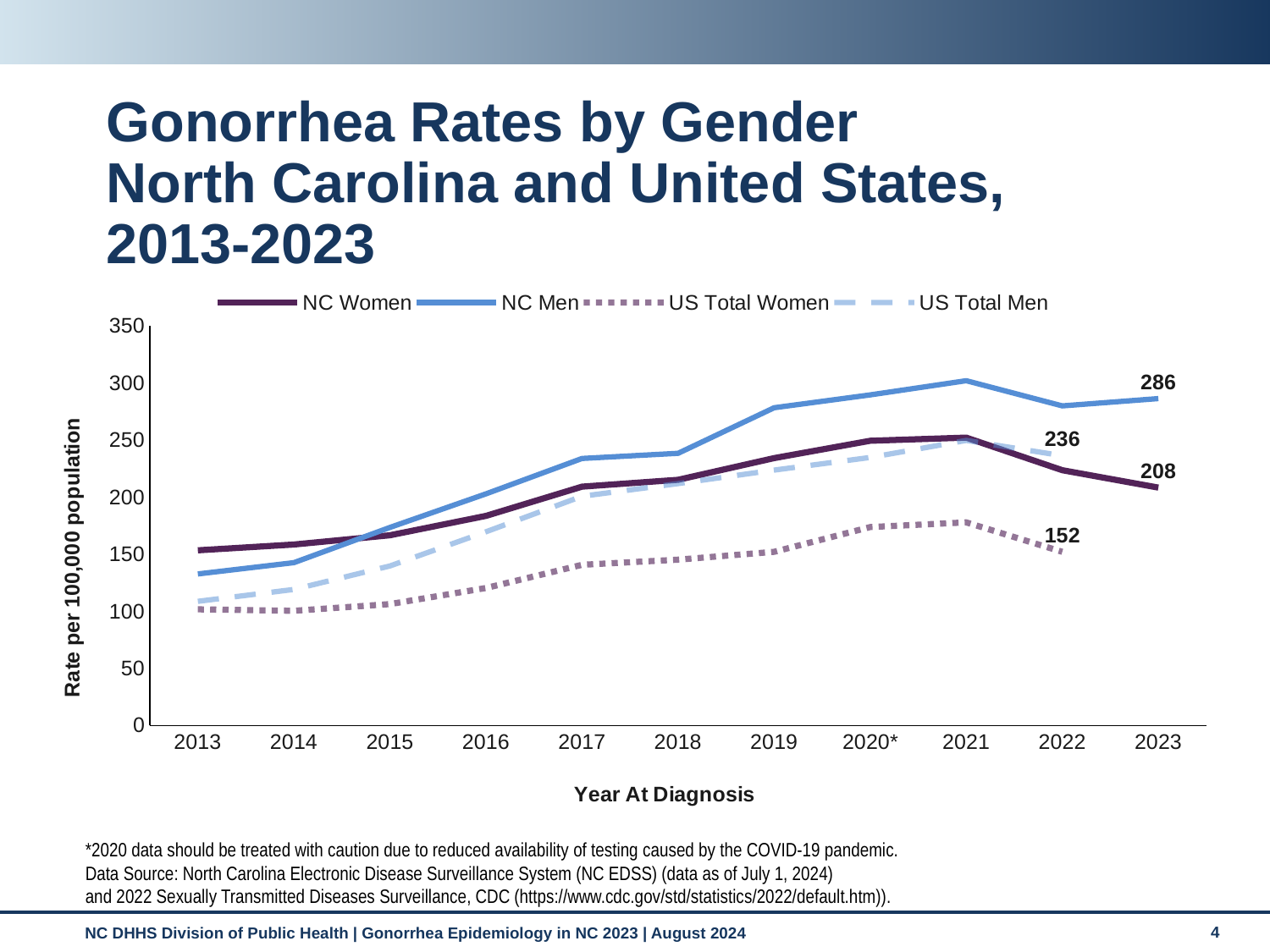
Which series has the higher rate in 2023, NC Men or NC Women? NC Men What is the difference between the US Total Men and US Total Women rates in 2022? 84 What is the US Total Men rate in 2022? 236 Does the NC Women rate rise or fall from 2021 to 2023? fall What is the difference between the NC Men and NC Women rates in 2023? 78 What is the NC Women gonorrhea rate in 2023? 208 What is the NC Men gonorrhea rate in 2023? 286 How many years are shown on the x axis? 11 How many series does the legend list? 4 What kind of chart is shown on the slide? Line chart Is the NC Men rate in 2013 greater or less than 150? less What is the US Total Women rate in 2022? 152